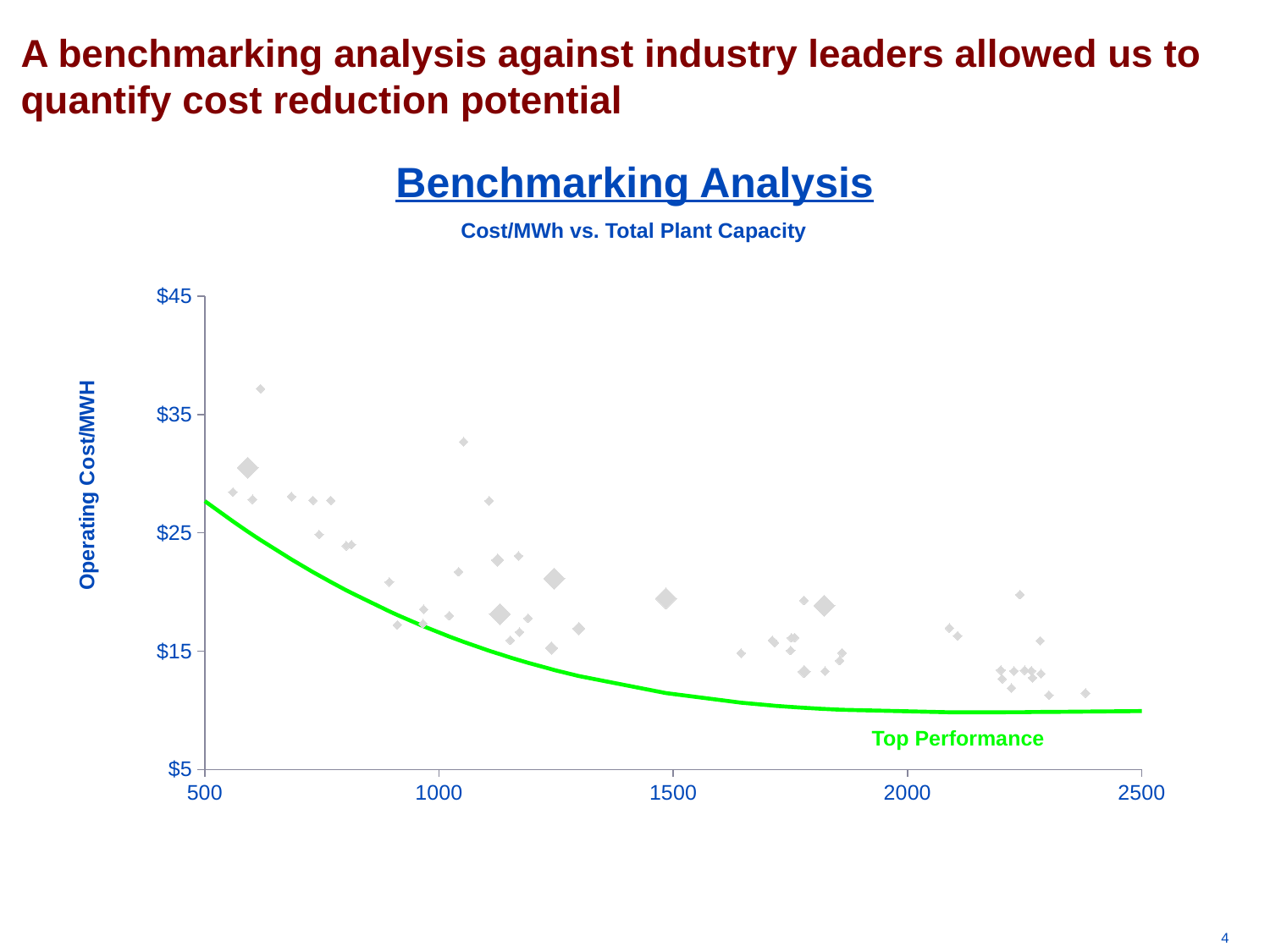
Is the value of the green Top Performance line at a capacity of 2500 greater or less than $15? less What is the lowest value shown on the x axis? 500 Is the highest plotted data point greater or less than $35 operating cost/MWh? greater Is the value of the green Top Performance line at a capacity of 1500 greater or less than $15? less What is the highest value shown on the y axis? $45 Are the plotted data points generally higher or lower in operating cost at larger plant capacities compared with smaller ones? lower What kind of chart is shown on the slide? scatter chart What is the subtitle shown under the chart title? Cost/MWh vs. Total Plant Capacity Does the green Top Performance line rise or fall as total plant capacity increases along the x axis? fall